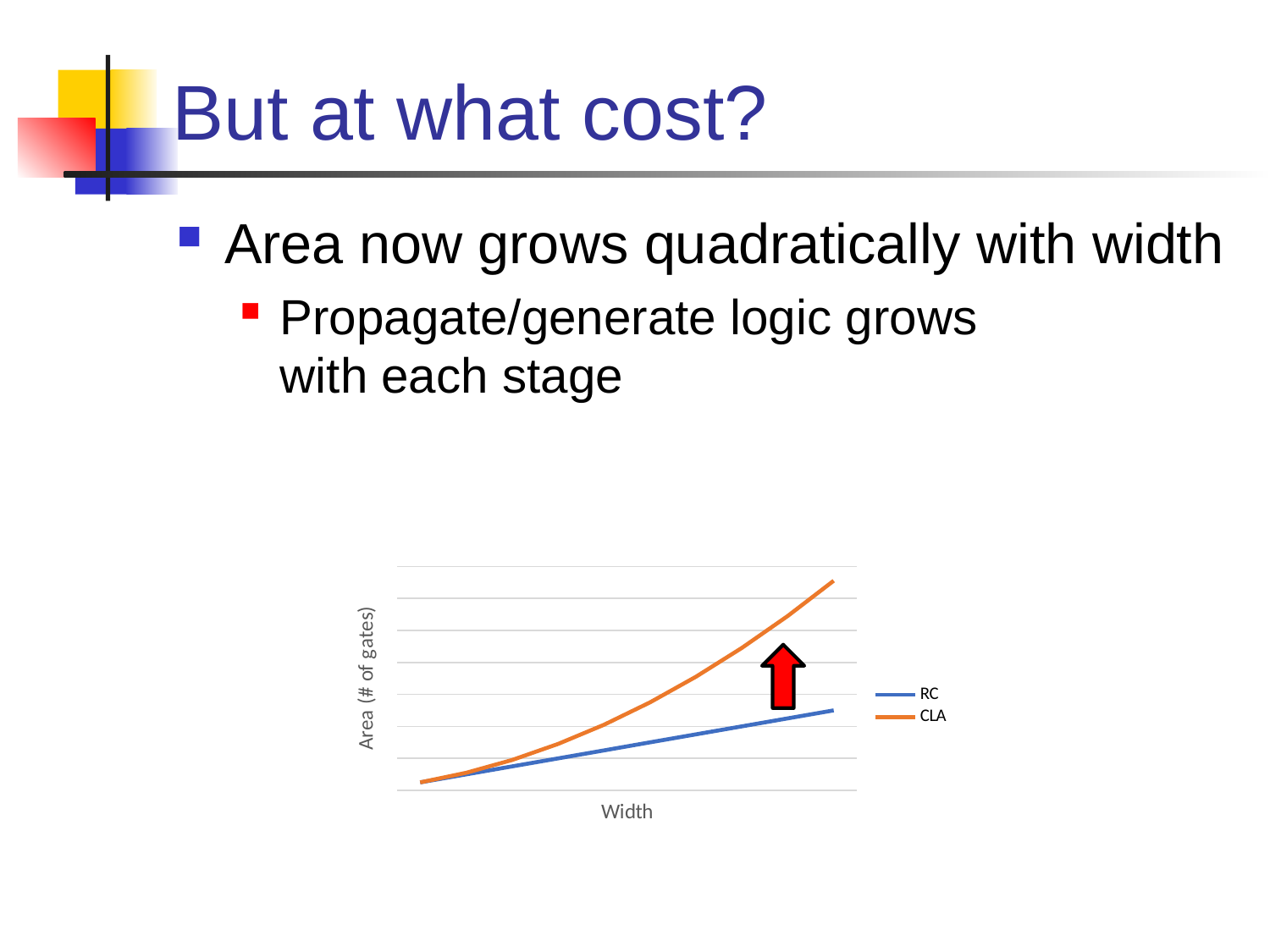
Which series has the lower value at the largest width shown? RC Which series reaches the highest value on the chart? CLA At the right end of the chart, which series has the larger area: RC or CLA? CLA How many series does the chart's legend list? 2 What kind of chart is shown on the slide? line chart Which series grows faster with width, RC or CLA? CLA Does the CLA line rise or fall as Width increases? rise What are the two series named in the chart's legend? RC and CLA Does the RC line rise or fall as Width increases? rise What is the label on the chart's vertical axis? Area (# of gates)